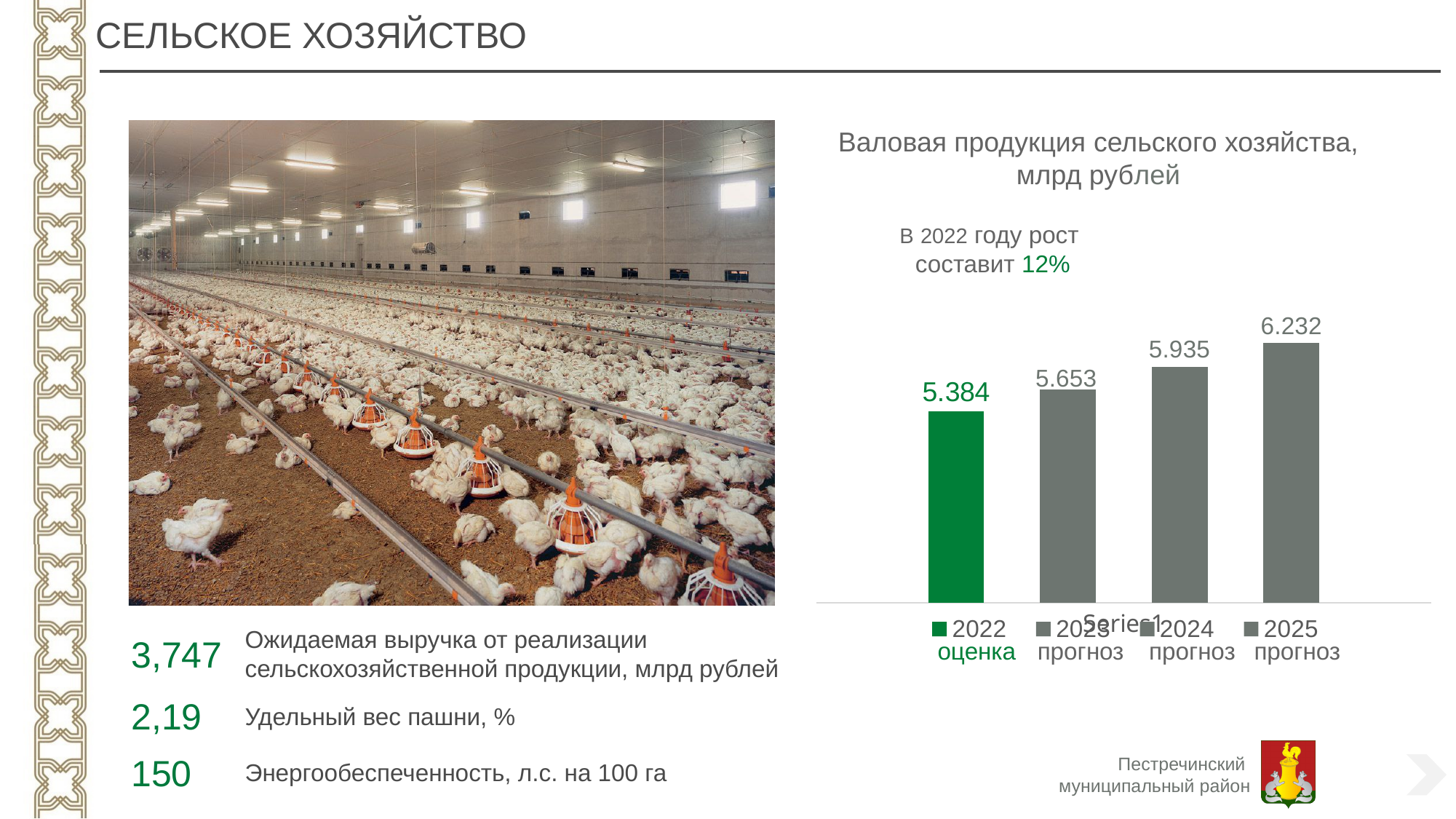
How many bars are shown in the chart? 4 What kind of chart is shown on the slide? bar chart Which category has the lowest value? 2022 оценка Which is larger, the value for 2024 прогноз or the value for 2023 прогноз? 2024 прогноз Which category has the highest value? 2025 прогноз What is the difference between the values for 2025 прогноз and 2022 оценка? 0.848 What is the value for 2022 оценка? 5.384 What is the value for 2024 прогноз? 5.935 What is the difference between the values for 2023 прогноз and 2022 оценка? 0.269 Do the values rise or fall from 2022 to 2025? rise What is the value for 2025 прогноз? 6.232 What is the value for 2023 прогноз? 5.653